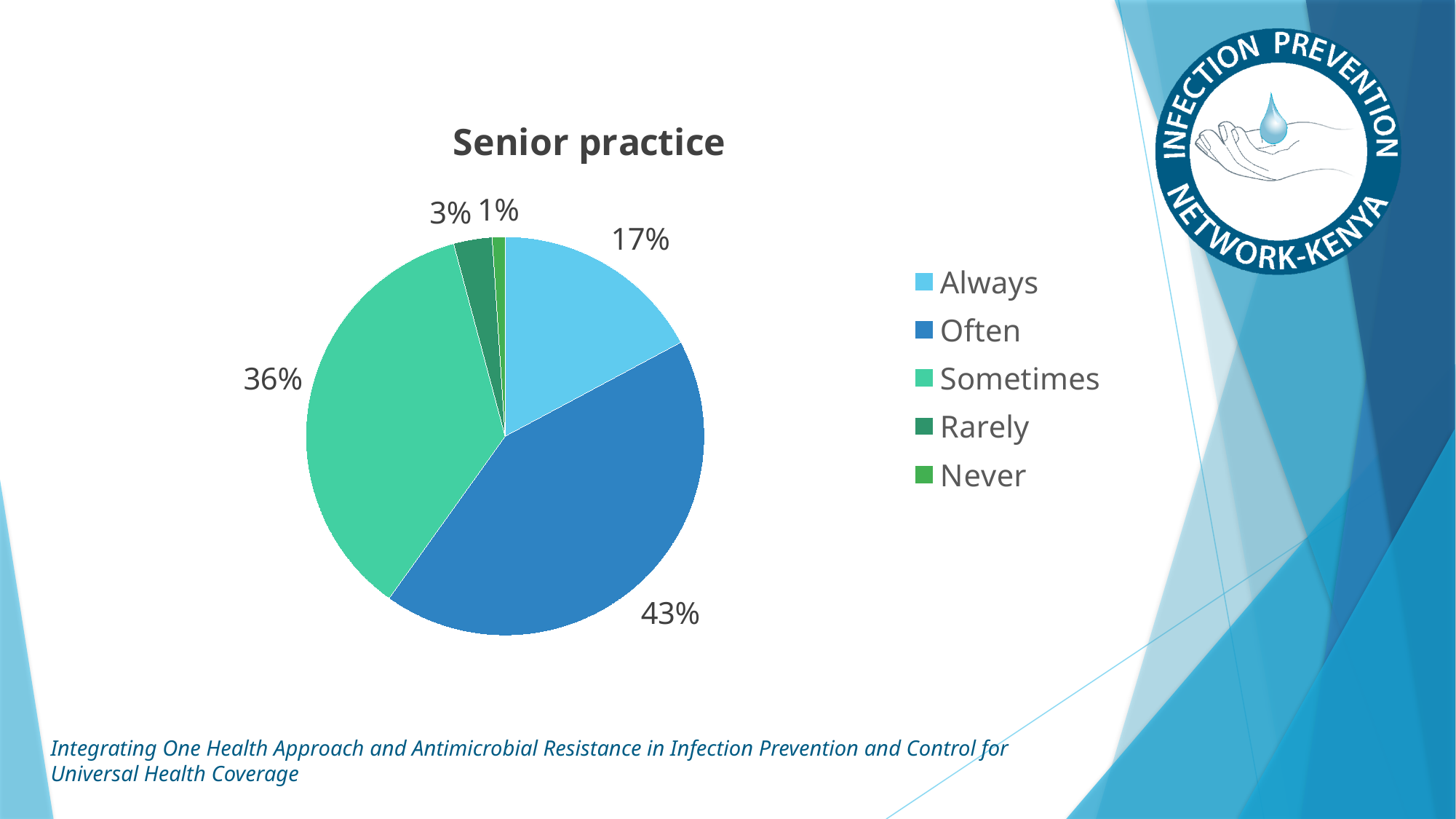
What percentage of the pie is labelled for Often? 43% What type of chart is shown on the slide? Pie chart What is the difference in percentage points between Often and Sometimes? 7 Which is larger, the slice for Always or the slice for Sometimes? Sometimes How many categories does the legend list? 5 Which category has the smallest slice of the pie? Never What percentage of the pie is labelled for Always? 17% What percentage of the pie is labelled for Rarely? 3% What percentage of the pie is labelled for Sometimes? 36% What is the title of the chart? Senior practice Which category has the largest slice of the pie? Often What percentage of the pie is labelled for Never? 1%